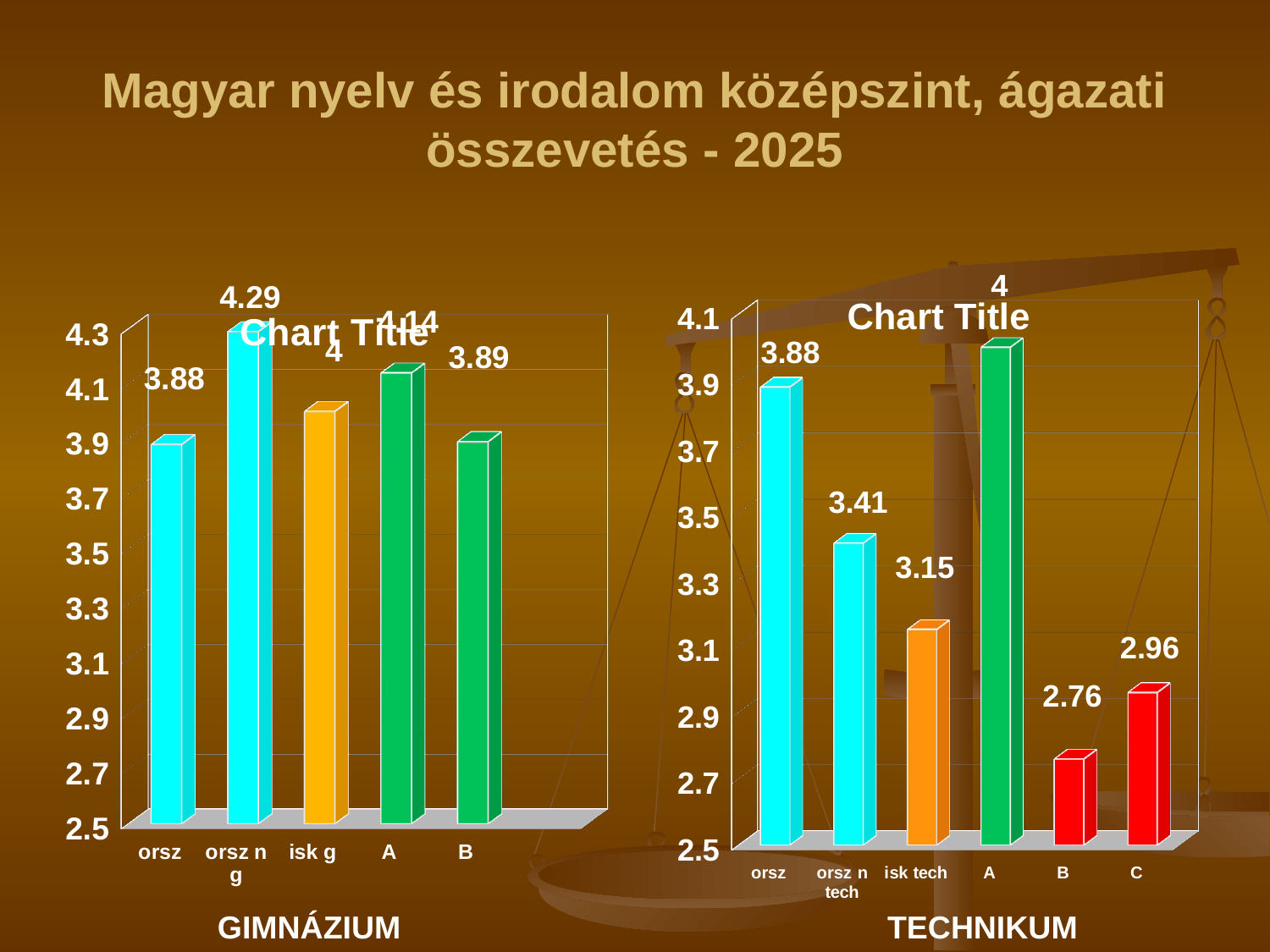
In the left chart (GIMNÁZIUM), what is the value for B? 3.89 In the right chart (TECHNIKUM), what is the value for C? 2.96 What type of chart is the right chart (TECHNIKUM)? bar chart In the right chart (TECHNIKUM), which category has the highest value? A In the left chart (GIMNÁZIUM), what is the value for orsz n g? 4.29 In the left chart (GIMNÁZIUM), what is the difference between the values for A and isk g? 0.14 In the right chart (TECHNIKUM), what is the value for isk tech? 3.15 In the left chart (GIMNÁZIUM), which category has the highest value? orsz n g In the left chart (GIMNÁZIUM), how many bars are plotted? 5 In the right chart (TECHNIKUM), which category has the lowest value? B In the right chart (TECHNIKUM), how many categories are shown on the x axis? 6 In the right chart (TECHNIKUM), what is the difference between the values for orsz and orsz n tech? 0.47